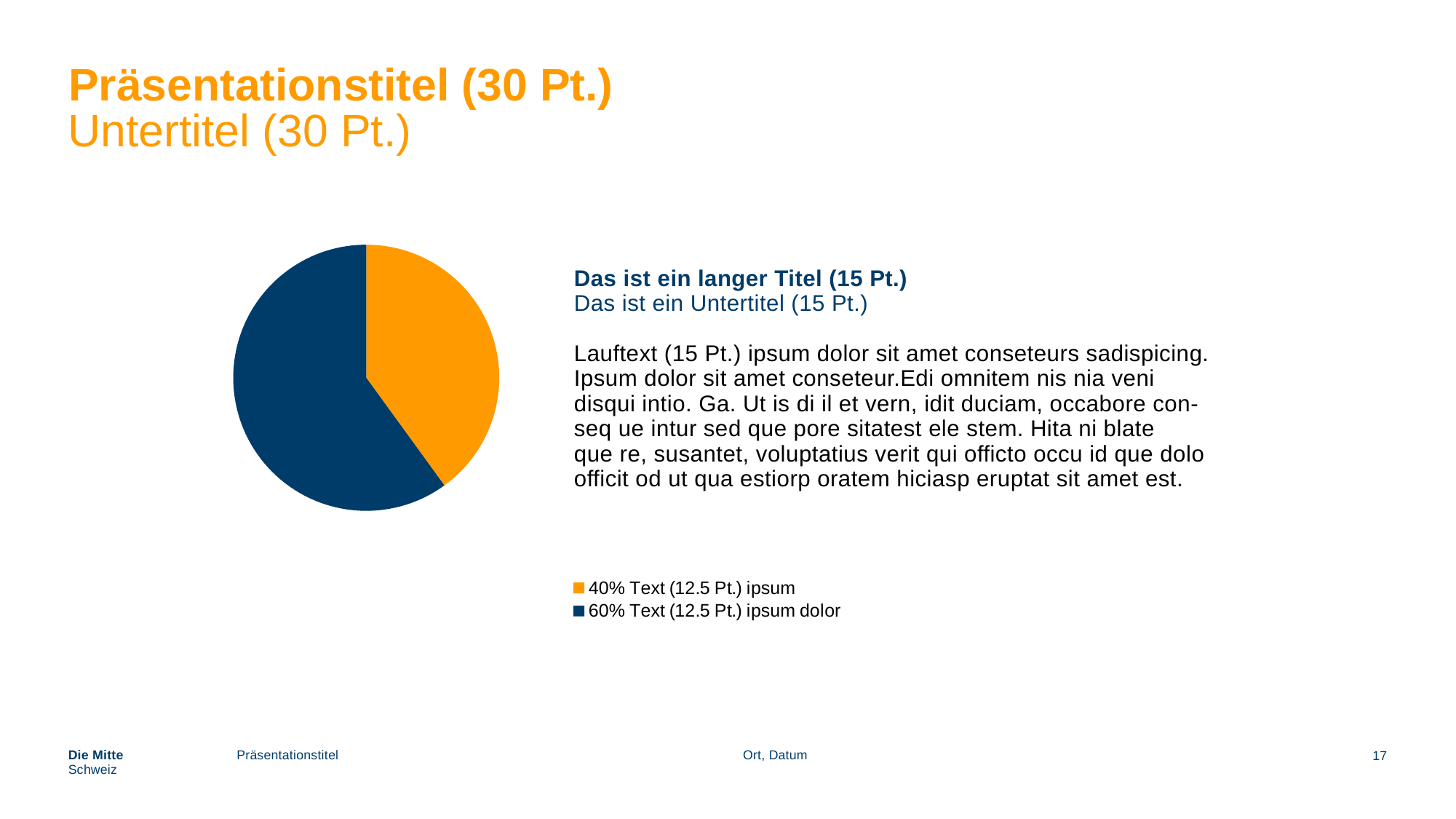
What share of the pie does the orange slice represent? 40% Which slice of the pie chart is the smallest? 40% Text (12.5 Pt.) ipsum What kind of chart is shown on the slide? pie chart What share of the pie does the dark blue slice represent? 60% How many slices does the pie chart have? 2 What colour is the slice labelled '60% Text (12.5 Pt.) ipsum dolor'? dark blue What is the legend label of the orange slice? 40% Text (12.5 Pt.) ipsum Which is larger in the pie chart, the orange slice or the dark blue slice? the dark blue slice Which slice of the pie chart is the largest? 60% Text (12.5 Pt.) ipsum dolor Is the share of the orange slice greater or less than 50%? less How many entries does the legend of the pie chart list? 2 What is the difference in percentage points between the two slices of the pie chart? 20